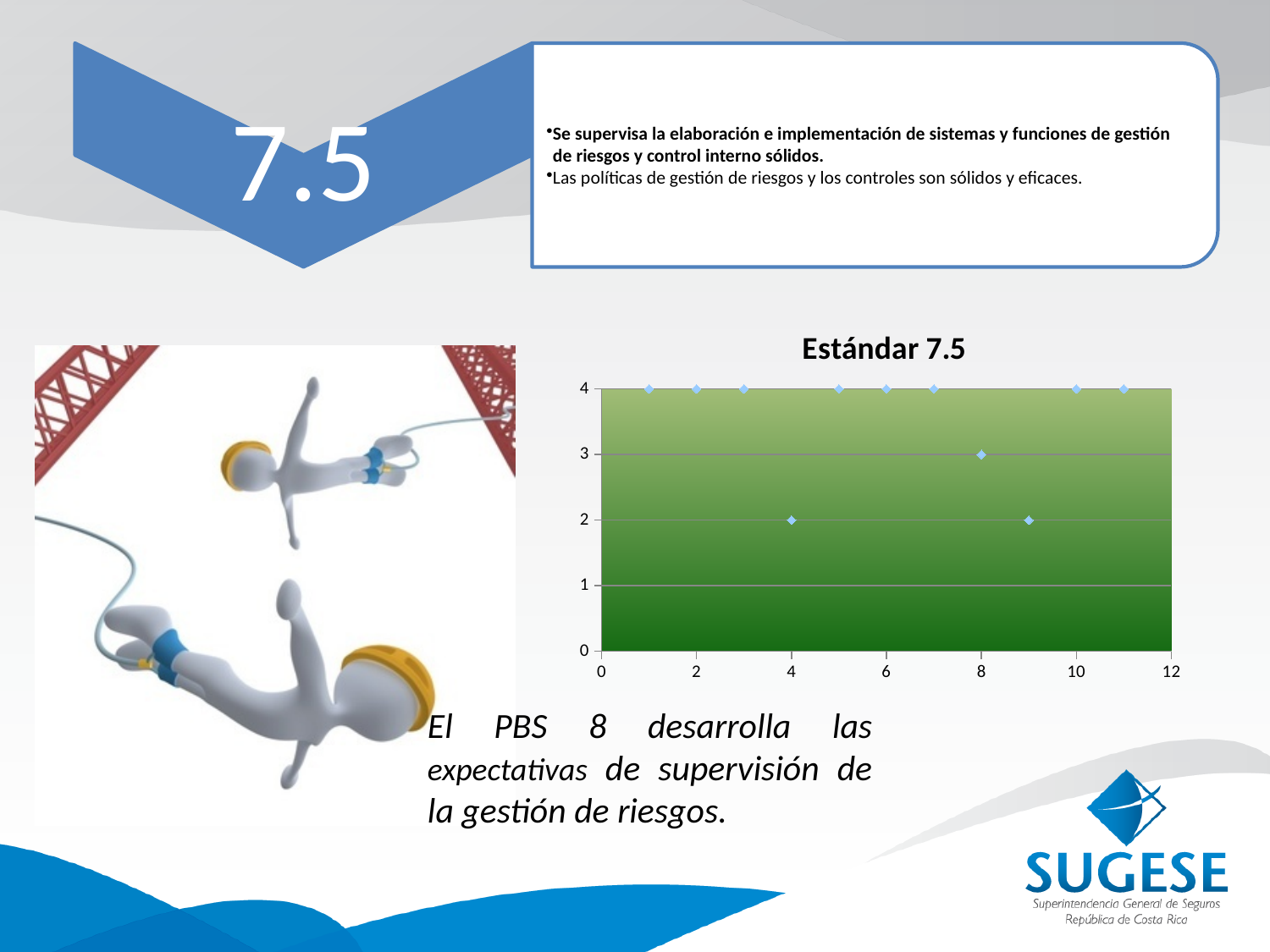
What is the difference between the value at x = 8 and the value at x = 4 in the Estándar 7.5 chart? 1 How many data points are plotted in the Estándar 7.5 chart? 11 What is the value of the point at x = 1 in the Estándar 7.5 chart? 4 What is the title of the chart? Estándar 7.5 Is the value of the point at x = 8 in the Estándar 7.5 chart greater or less than 2? greater What is the value of the point at x = 9 in the Estándar 7.5 chart? 2 Which has the larger value in the Estándar 7.5 chart, the point at x = 8 or the point at x = 9? x = 8 How many points in the Estándar 7.5 chart have a value of 4? 8 What is the highest value shown on the vertical axis of the Estándar 7.5 chart? 4 What is the value of the point at x = 8 in the Estándar 7.5 chart? 3 What kind of chart is shown under the title Estándar 7.5? scatter chart What is the value of the point at x = 4 in the Estándar 7.5 chart? 2